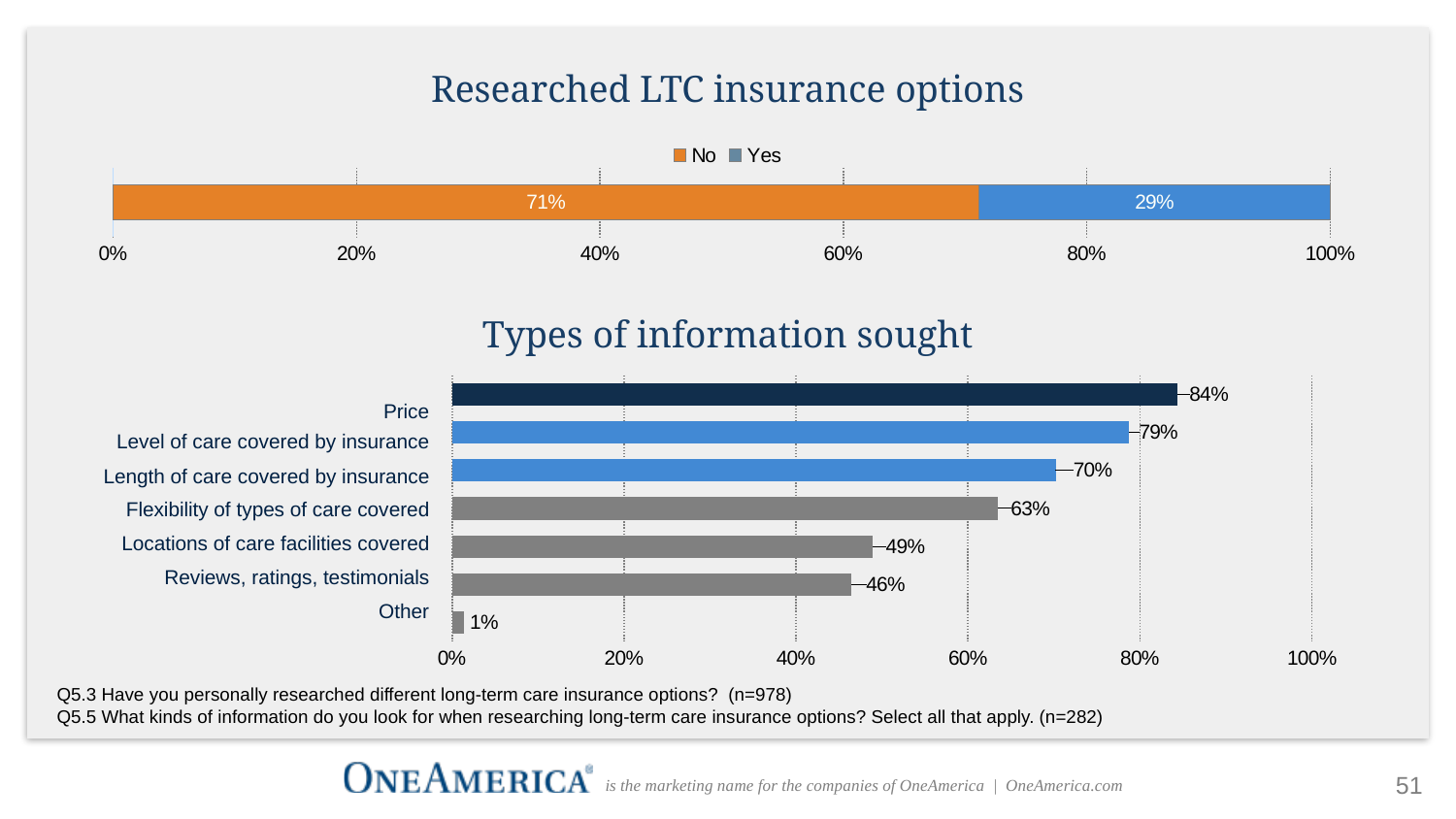
What kind of chart is 'Types of information sought'? Bar chart In the 'Types of information sought' chart, which category has the highest value? Price In the 'Types of information sought' chart, how many categories are shown? 7 In the 'Types of information sought' chart, which category has the lowest value? Other In the 'Types of information sought' chart, what is the value for Price? 84% In the 'Types of information sought' chart, which is larger: Flexibility of types of care covered or Reviews, ratings, testimonials? Flexibility of types of care covered In the 'Researched LTC insurance options' chart, how many series does the legend list? 2 In the 'Researched LTC insurance options' chart, what percentage answered Yes? 29% In the 'Researched LTC insurance options' chart, what is the difference between the No and Yes percentages? 42% In the 'Types of information sought' chart, what is the value for Locations of care facilities covered? 49% In the 'Types of information sought' chart, what is the difference between Level of care covered by insurance and Length of care covered by insurance? 9% In the 'Researched LTC insurance options' chart, what percentage answered No? 71%